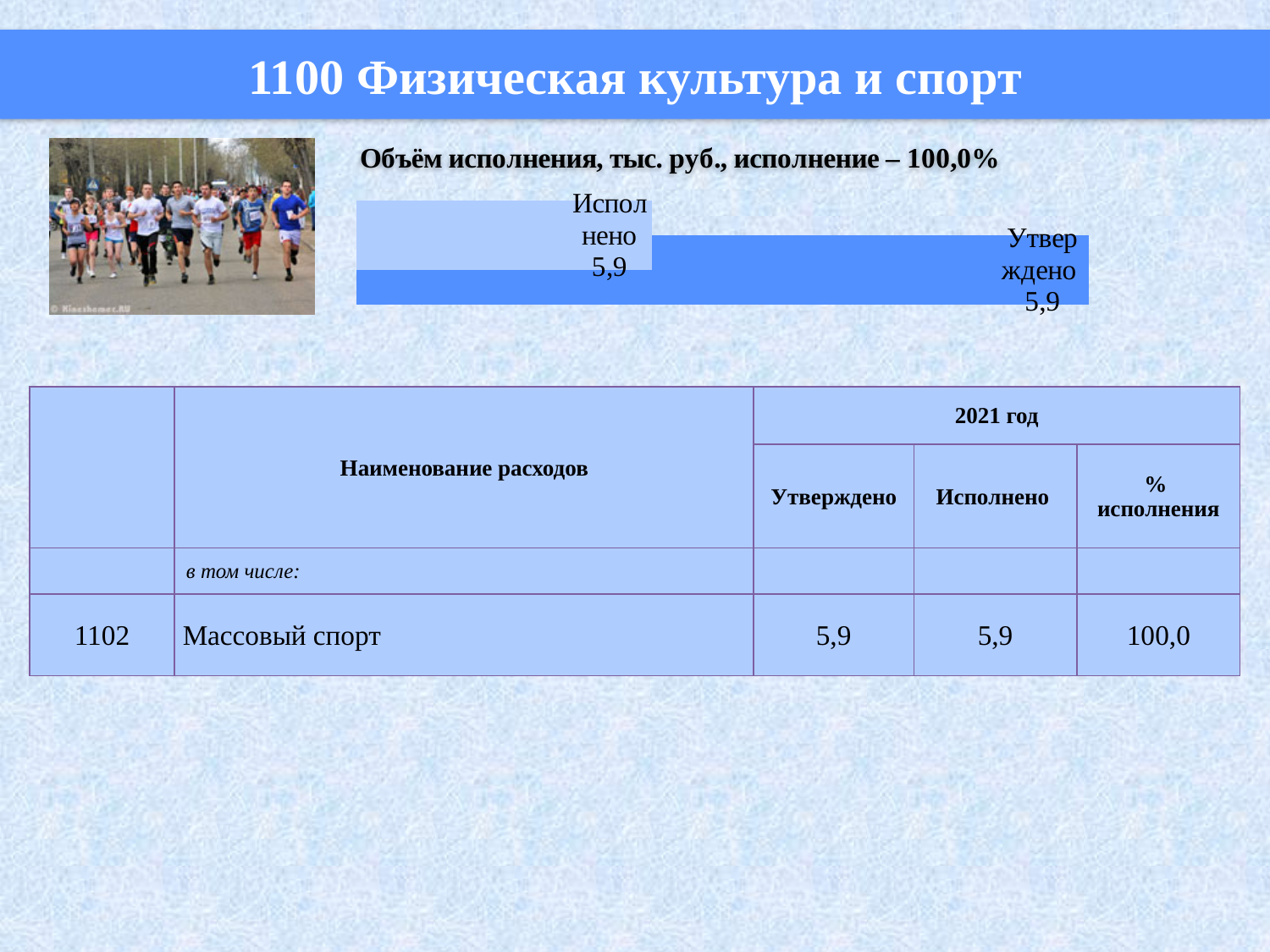
What is the value of the Исполнено bar in the chart? 5,9 What execution percentage is stated in the chart title? 100,0% What is the title of the chart? Объём исполнения, тыс. руб., исполнение – 100,0% What kind of chart is shown on the slide? bar chart What is the value of the Утверждено bar in the chart? 5,9 How many bars are plotted in the chart? 2 What is the difference between the Утверждено and Исполнено values in the chart? 0,0